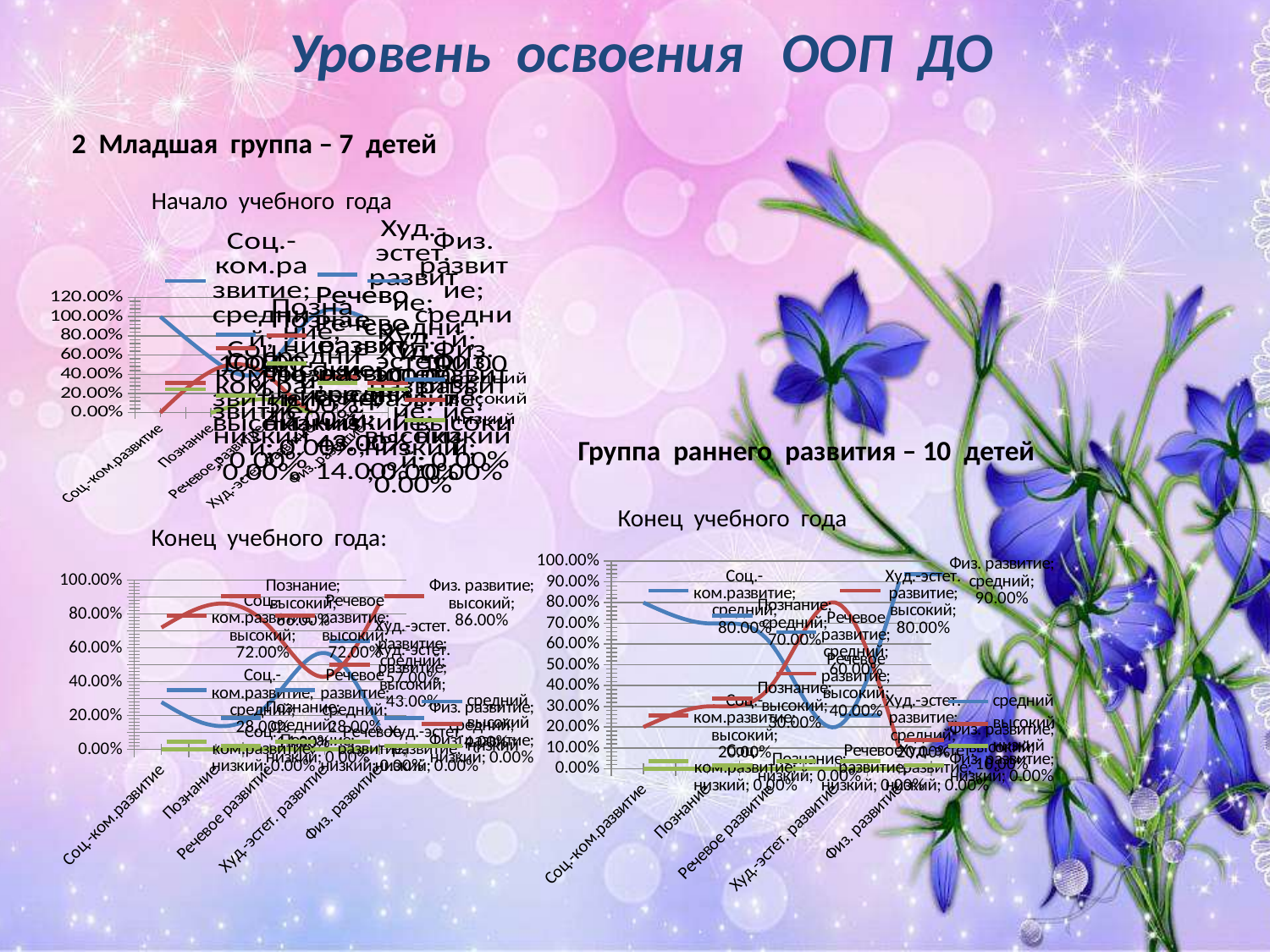
On the 'Конец учебного года' chart for the Группа раннего развития (right side), what is the value for Соц.-ком.развитие in the средний series? 80.00% On the 'Конец учебного года' chart for the Группа раннего развития (right side), what is the difference between the средний values for Соц.-ком.развитие and Речевое развитие? 20.00% On the 'Конец учебного года' chart for the Группа раннего развития (right side), what is the value for Речевое развитие in the высокий series? 40.00% On the 'Конец учебного года' chart for the Группа раннего развития (right side), which category has the highest средний value? Физ. развитие On the 'Конец учебного года' chart for the Группа раннего развития (right side), what is the value for Худ.-эстет. развитие in the высокий series? 80.00% On the 'Конец учебного года' chart for the Группа раннего развития (right side), how many series does the legend list? 3 On the 'Конец учебного года:' chart for the 2 Младшая группа (bottom left), what is the value for Физ. развитие in the высокий series? 86.00% On the 'Конец учебного года:' chart for the 2 Младшая группа (bottom left), what is the value for Физ. развитие in the низкий series? 0.00% On the 'Конец учебного года' chart for the Группа раннего развития (right side), what is the value for Физ. развитие in the средний series? 90.00% What kind of chart is the 'Конец учебного года' chart for the Группа раннего развития (right side)? line chart On the 'Конец учебного года:' chart for the 2 Младшая группа (bottom left), what is the value for Соц.-ком.развитие in the высокий series? 72.00% On the 'Конец учебного года:' chart for the 2 Младшая группа (bottom left), what is the value for Худ.-эстет. развитие in the средний series? 57.00%